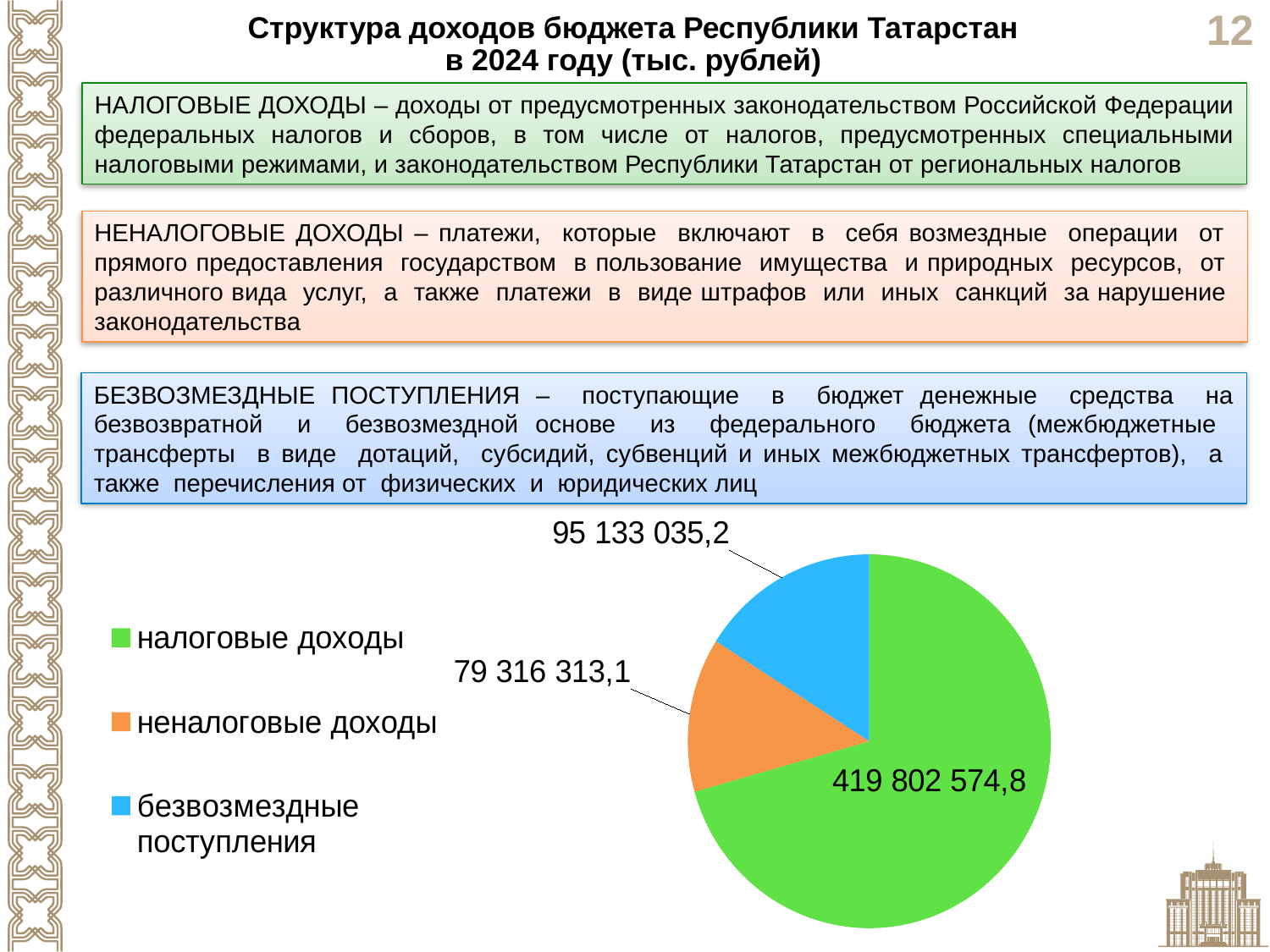
What is the value for налоговые доходы in the pie chart? 419 802 574,8 Which category has the largest slice in the pie chart? налоговые доходы What colour is the slice for безвозмездные поступления? blue How many categories does the pie chart show? 3 What is the value for безвозмездные поступления in the pie chart? 95 133 035,2 What is the total of all three slices in the pie chart? 594 251 923,1 What type of chart is shown on the slide? pie chart What is the value for неналоговые доходы in the pie chart? 79 316 313,1 What is the difference between налоговые доходы and безвозмездные поступления? 324 669 539,6 What is the difference between безвозмездные поступления and неналоговые доходы? 15 816 722,1 Which is larger: безвозмездные поступления or неналоговые доходы? безвозмездные поступления Which category has the smallest slice in the pie chart? неналоговые доходы